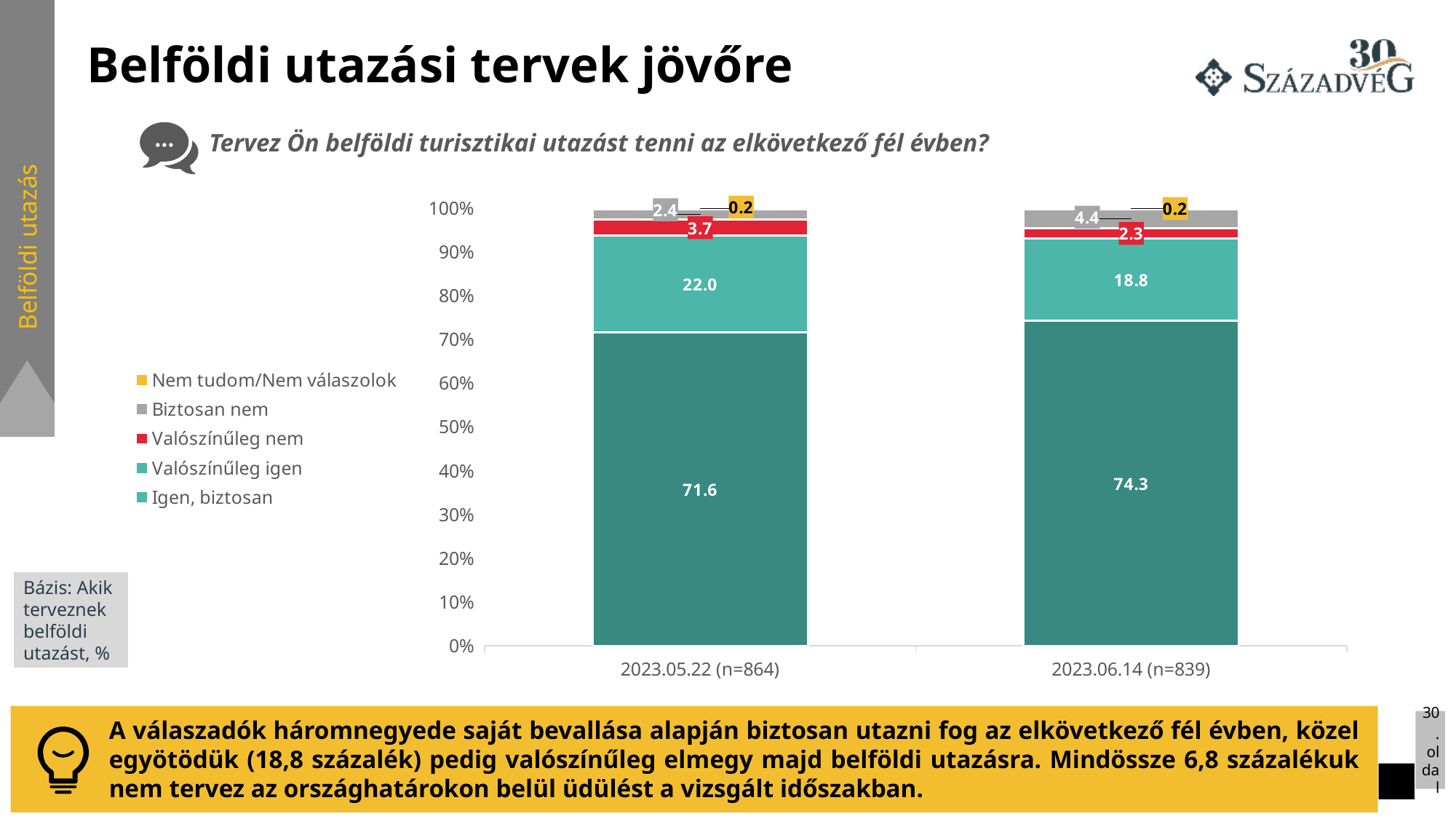
What is the value for "Valószínűleg igen" for 2023.05.22 (n=864)? 22.0 What is the difference between the "Igen, biztosan" values for 2023.06.14 and 2023.05.22? 2.7 What is the value for "Valószínűleg nem" for 2023.05.22 (n=864)? 3.7 How many series does the legend list? 5 Which series has the smallest value in the 2023.06.14 (n=839) bar? Nem tudom/Nem válaszolok How many bars (survey dates) are shown in the chart? 2 Which series has the largest value in the 2023.05.22 (n=864) bar? Igen, biztosan What kind of chart is shown on the slide? Stacked bar chart What is the value for "Igen, biztosan" for 2023.06.14 (n=839)? 74.3 What is the value for "Biztosan nem" for 2023.06.14 (n=839)? 4.4 Does the "Igen, biztosan" value rise or fall from 2023.05.22 to 2023.06.14? Rise Which date has the larger "Valószínűleg igen" value, 2023.05.22 or 2023.06.14? 2023.05.22